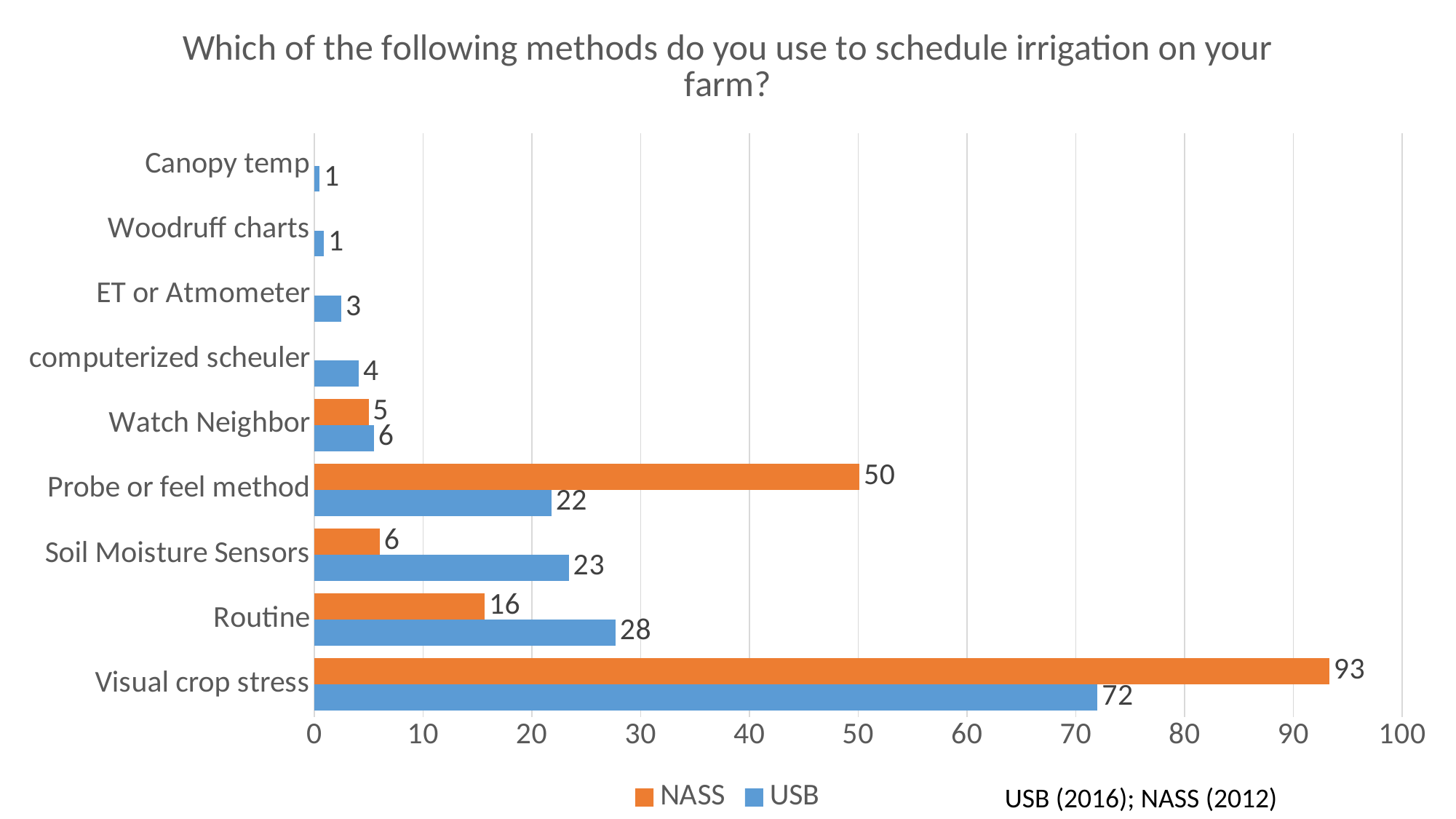
What is the USB value for Soil Moisture Sensors? 23 Which category has the highest NASS value? Visual crop stress What kind of chart is shown on the slide? Bar chart How many categories are shown on the chart? 9 Which category has the lowest USB value? Canopy temp How many series does the legend list? 2 What is the USB value for Visual crop stress? 72 What is the NASS value for Probe or feel method? 50 Which is larger for Routine, the NASS value or the USB value? USB What is the difference between the NASS and USB values for Visual crop stress? 21 Is the NASS value for Visual crop stress greater or less than 90? greater Which colour represents the NASS series? Orange